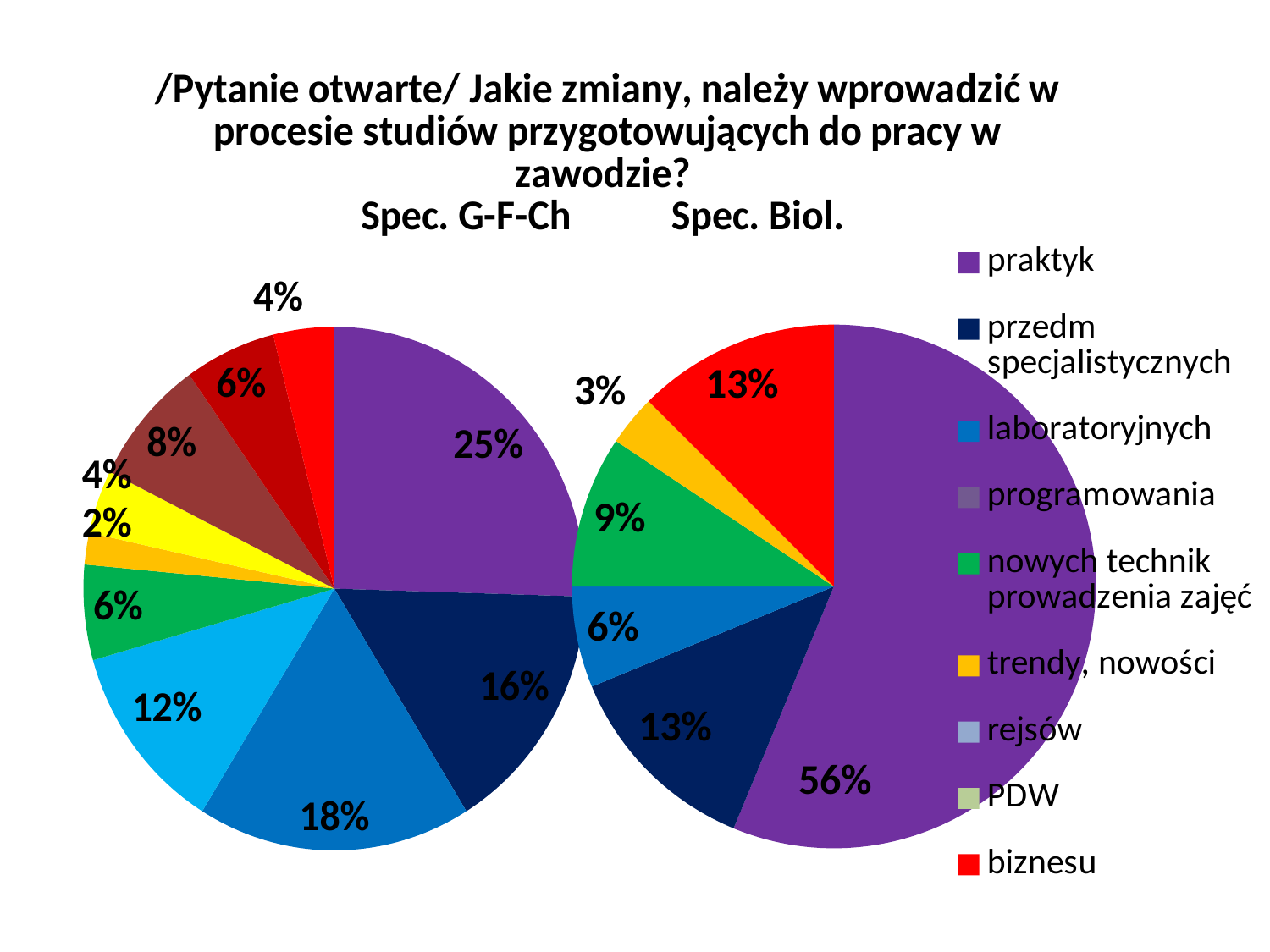
How many slices does the Spec. Biol. pie chart have? 6 In the Spec. G-F-Ch chart, what share does laboratoryjnych have? 18% In the Spec. Biol. chart, which category has the smallest slice? trendy, nowości In the Spec. G-F-Ch chart, which is larger: laboratoryjnych or przedm specjalistycznych? laboratoryjnych What kind of charts are shown on the slide? Pie charts Which chart shows a larger share for praktyk, Spec. G-F-Ch or Spec. Biol.? Spec. Biol. In the Spec. Biol. chart, which category has the largest slice? praktyk In the Spec. Biol. chart, what share does praktyk have? 56% How many entries does the legend list? 9 In the Spec. G-F-Ch chart, what share does praktyk have? 25% In the Spec. Biol. chart, what share does nowych technik prowadzenia zajęć have? 9% In the Spec. Biol. chart, what is the difference between the praktyk share and the przedm specjalistycznych share? 43 percentage points